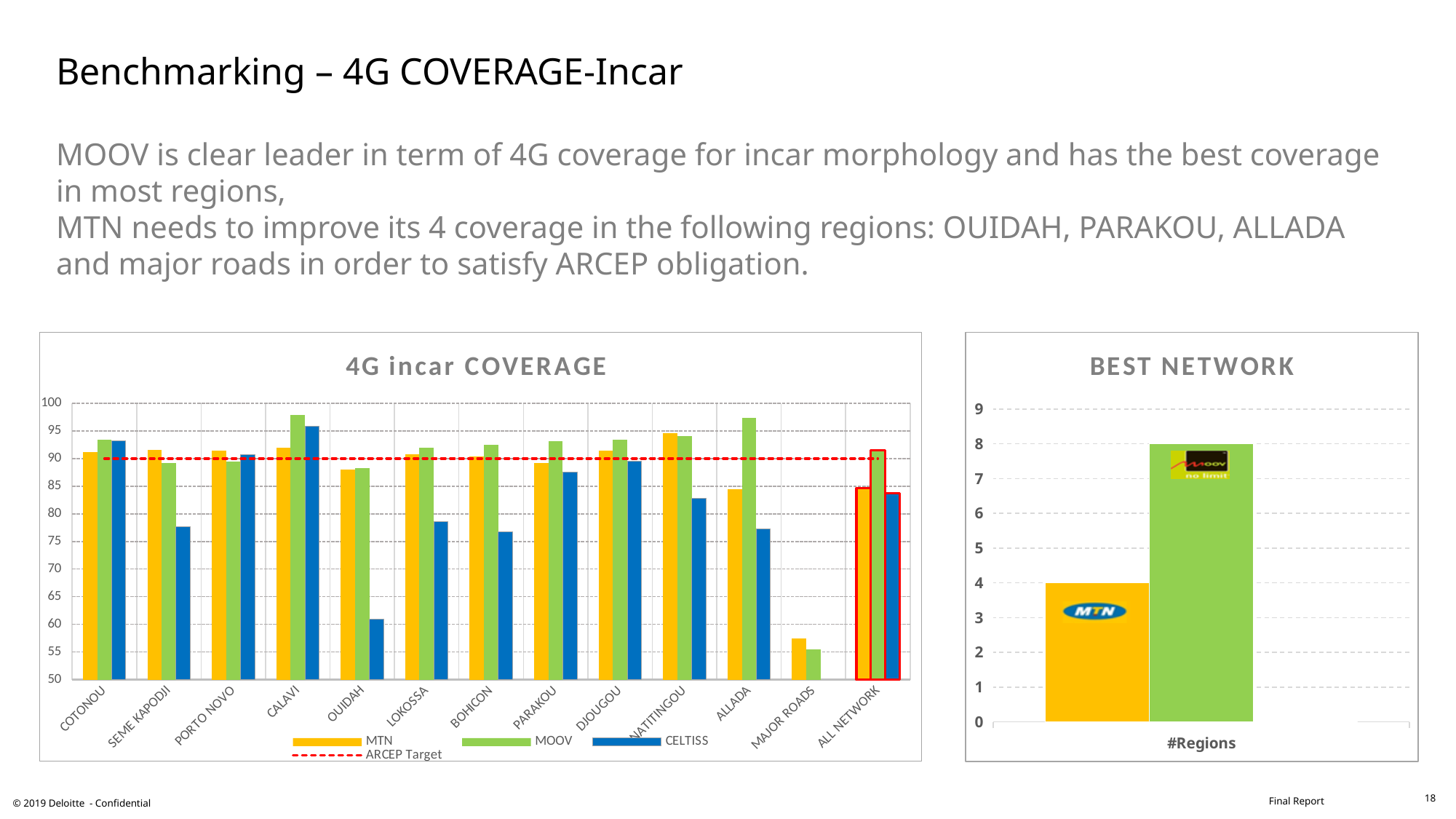
In the 4G incar COVERAGE chart, what does the red dashed line represent according to the legend? ARCEP Target In the 4G incar COVERAGE chart, which is larger at OUIDAH: the MOOV value or the CELTISS value? MOOV In the 4G incar COVERAGE chart, how many categories are shown on the x axis? 13 In the 4G incar COVERAGE chart, is the value for CELTISS at OUIDAH greater or less than 70? less In the BEST NETWORK chart, what is the value for MTN? 4 In the 4G incar COVERAGE chart, is the value for MOOV at CALAVI greater or less than 95? greater In the 4G incar COVERAGE chart, is the value for MTN at MAJOR ROADS greater or less than 60? less What kind of chart is the 4G incar COVERAGE chart? Combination bar and line chart In the BEST NETWORK chart, what is the difference between the MOOV and MTN values? 4 In the BEST NETWORK chart, which network has the higher number of regions? MOOV In the BEST NETWORK chart, what is the value for MOOV? 8 In the 4G incar COVERAGE chart, how many entries does the legend list? 4